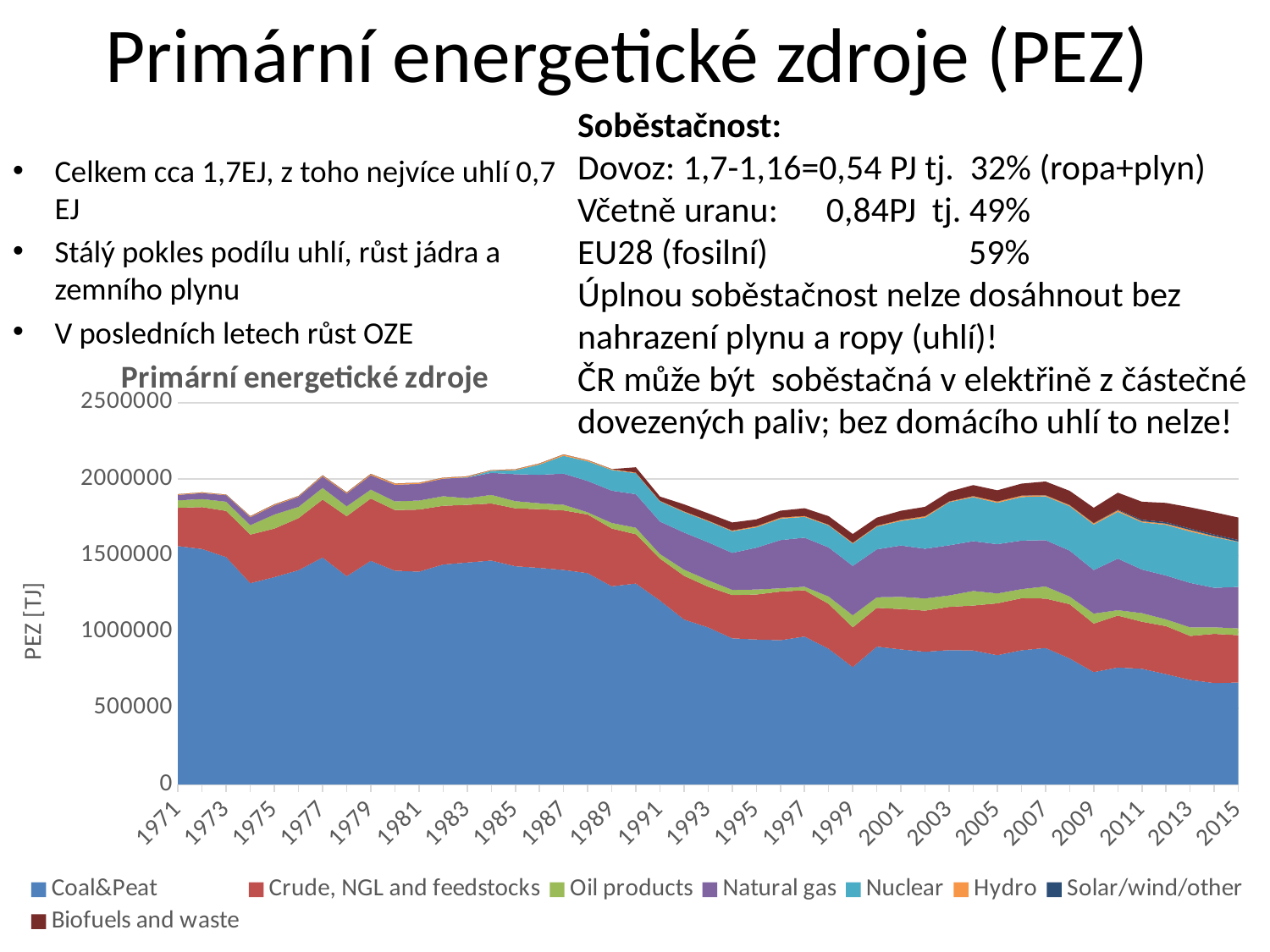
Is the total of all series in 2015 greater or less than 2000000? less Is the value for Coal&Peat in 2015 greater or less than 1000000? less What type of chart is shown on the slide? stacked area chart How many series does the chart legend list? 8 Does the Coal&Peat area rise or fall from 1971 to 2015? fall What is the first year shown on the x axis of the chart? 1971 Is the total of all series in 1987 greater or less than 2000000? greater Which series is plotted at the bottom of the stacked area chart? Coal&Peat What is the label of the vertical axis of the chart? PEZ [TJ] What is the title of the chart? Primární energetické zdroje What is the last year shown on the x axis of the chart? 2015